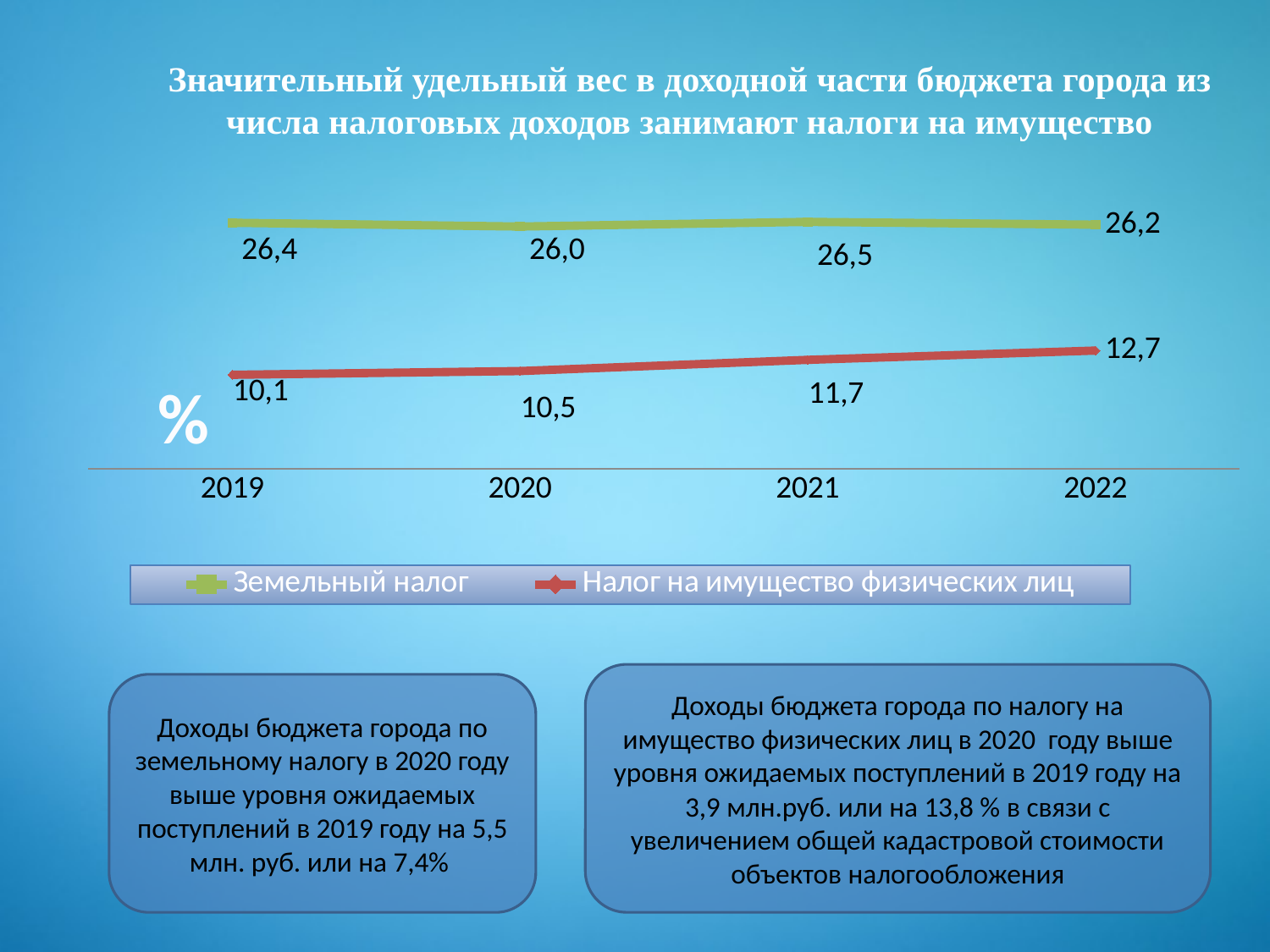
What kind of chart is shown on the slide? line chart In which year is Налог на имущество физических лиц lowest? 2019 What is the value for Земельный налог in 2019? 26,4 Which is larger in 2020: Земельный налог or Налог на имущество физических лиц? Земельный налог In which year is Земельный налог highest? 2021 What colour is the line for Земельный налог? green How many series does the legend list? 2 What is the difference between Налог на имущество физических лиц in 2022 and in 2019? 2,6 What is the value for Налог на имущество физических лиц in 2022? 12,7 What is the value for Налог на имущество физических лиц in 2021? 11,7 Does Налог на имущество физических лиц rise or fall from 2019 to 2022? rise How many years are shown on the x axis? 4